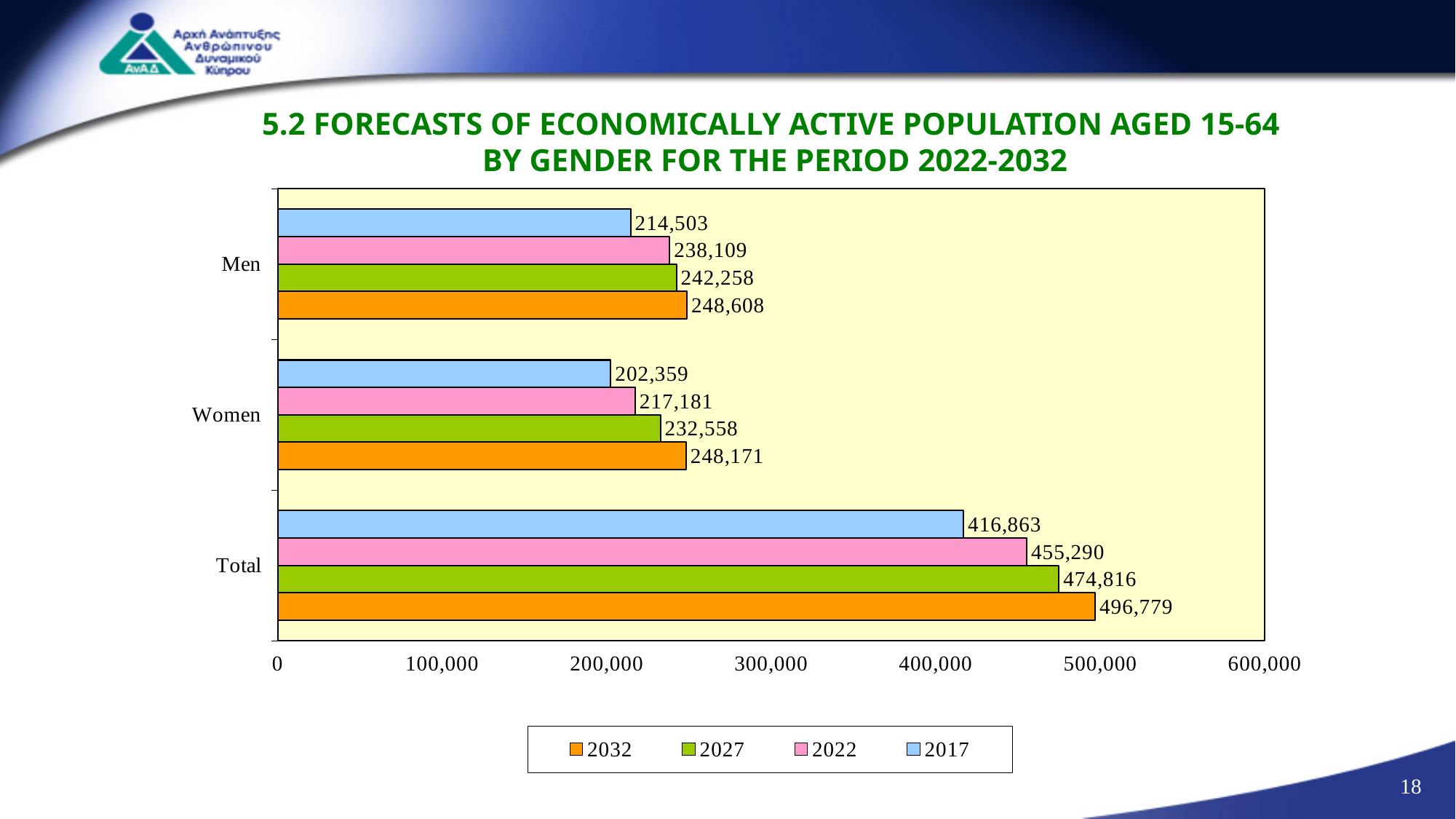
What is the value for Women in 2017? 202,359 Which year has the lowest value for Men? 2017 What is the difference between the Total values for 2032 and 2027? 21,963 What is the value for Women in 2022? 217,181 How many series does the legend list? 4 Is the Total value for 2017 greater or less than 400,000? greater What is the forecast value for Men in 2032? 248,608 Which year has the highest Total value? 2032 What kind of chart is shown on the slide? bar chart What is the difference between the Men values for 2032 and 2017? 34,105 Which is larger: the value for Men in 2022 or the value for Women in 2022? Men in 2022 What is the Total value for 2027? 474,816